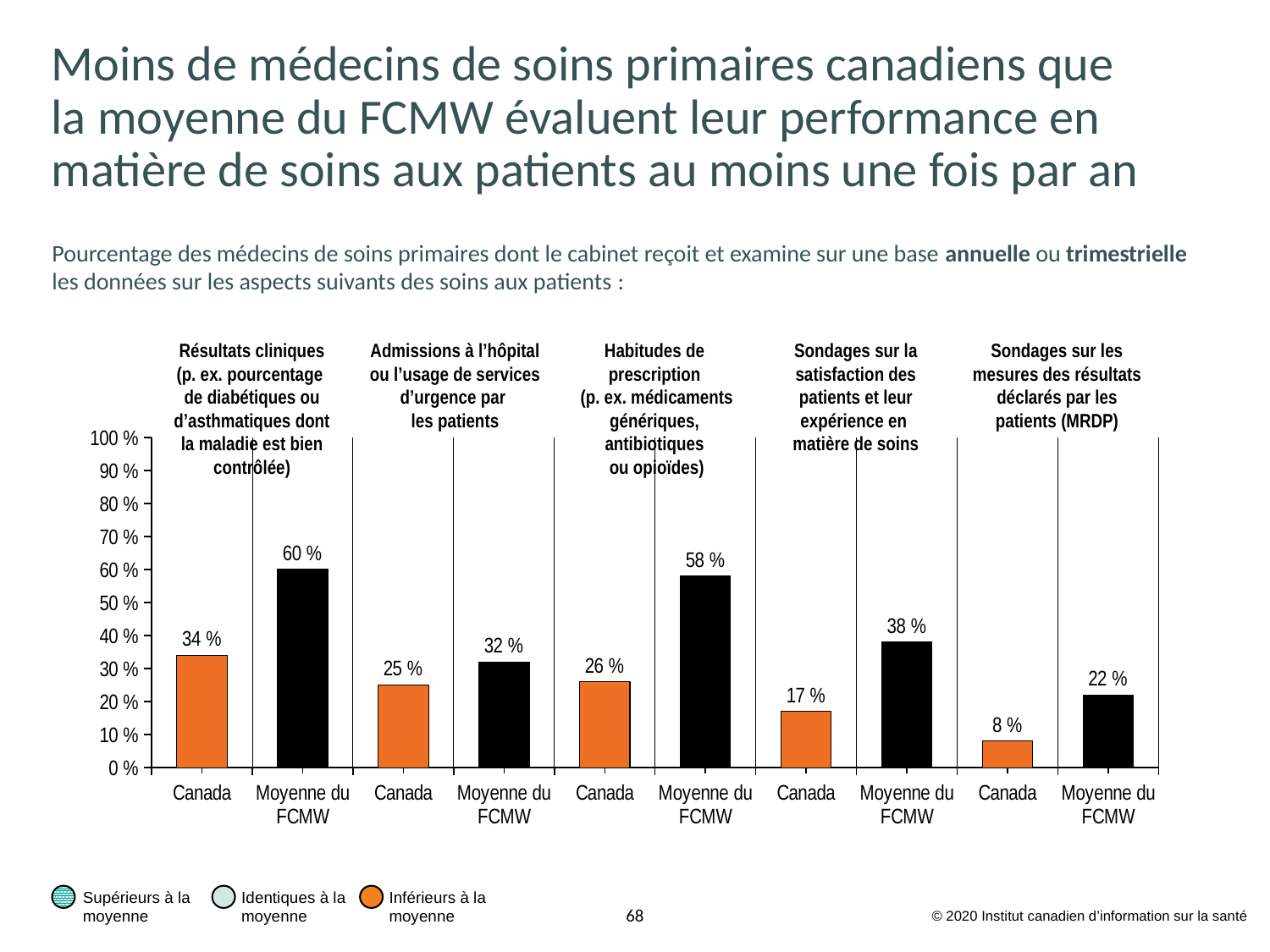
Combien de barres le graphique contient-il ? 10 Quelle est la différence entre la moyenne du FCMW et le Canada pour « Habitudes de prescription » ? 32 points de pourcentage De quel type de graphique s'agit-il ? Graphique à barres Quelle barre affiche la valeur la plus faible du graphique ? Canada, Sondages sur les mesures des résultats déclarés par les patients (MRDP) (8 %) Quelle est la valeur pour le Canada dans la catégorie « Sondages sur les mesures des résultats déclarés par les patients (MRDP) » ? 8 % Quelle est la valeur de la moyenne du FCMW pour « Admissions à l'hôpital ou l'usage de services d'urgence par les patients » ? 32 % Quelle est la différence entre la moyenne du FCMW et le Canada pour « Sondages sur la satisfaction des patients et leur expérience en matière de soins » ? 21 points de pourcentage Quelle couleur est utilisée pour les barres du Canada ? Orange Quelle barre affiche la valeur la plus élevée du graphique ? Moyenne du FCMW, Résultats cliniques (60 %) Quelle est la valeur de la moyenne du FCMW pour « Habitudes de prescription » ? 58 % Quelle est la valeur pour le Canada dans la catégorie « Résultats cliniques » ? 34 % Pour « Admissions à l'hôpital ou l'usage de services d'urgence par les patients », quelle valeur est la plus élevée : le Canada ou la moyenne du FCMW ? Moyenne du FCMW